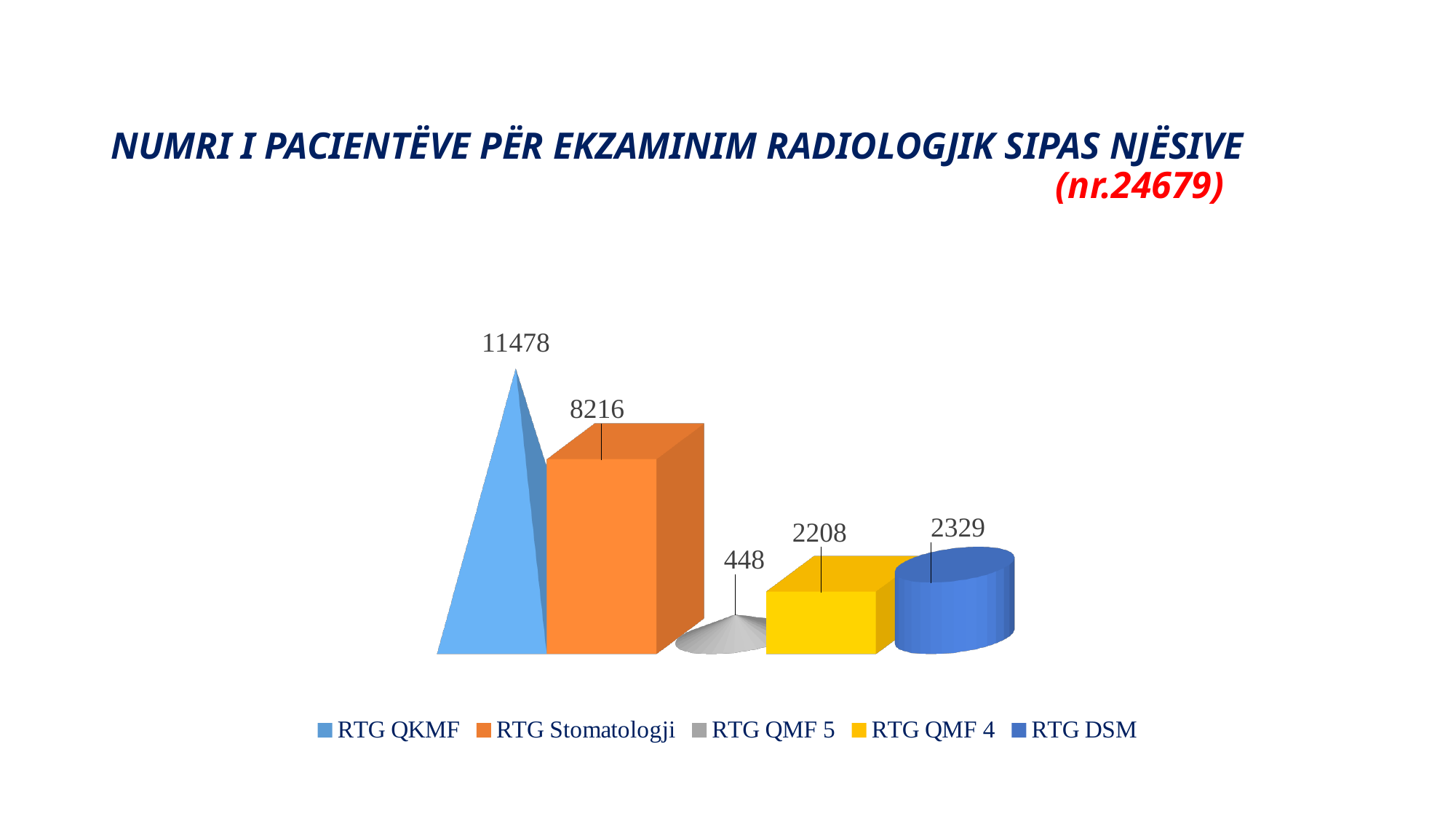
How many units are shown in the chart? 5 Which unit has the lowest number of patients? RTG QMF 5 What is the difference between the values for RTG DSM and RTG QMF 4? 121 What is the value for RTG QMF 5? 448 Which is larger, the value for RTG QMF 4 or the value for RTG QMF 5? RTG QMF 4 How many entries does the legend list? 5 What is the difference between the values for RTG QKMF and RTG Stomatologji? 3262 What is the value for RTG DSM? 2329 What is the value for RTG Stomatologji? 8216 What total number is shown in red under the chart title? (nr.24679) What is the value for RTG QKMF? 11478 Which unit has the highest number of patients? RTG QKMF